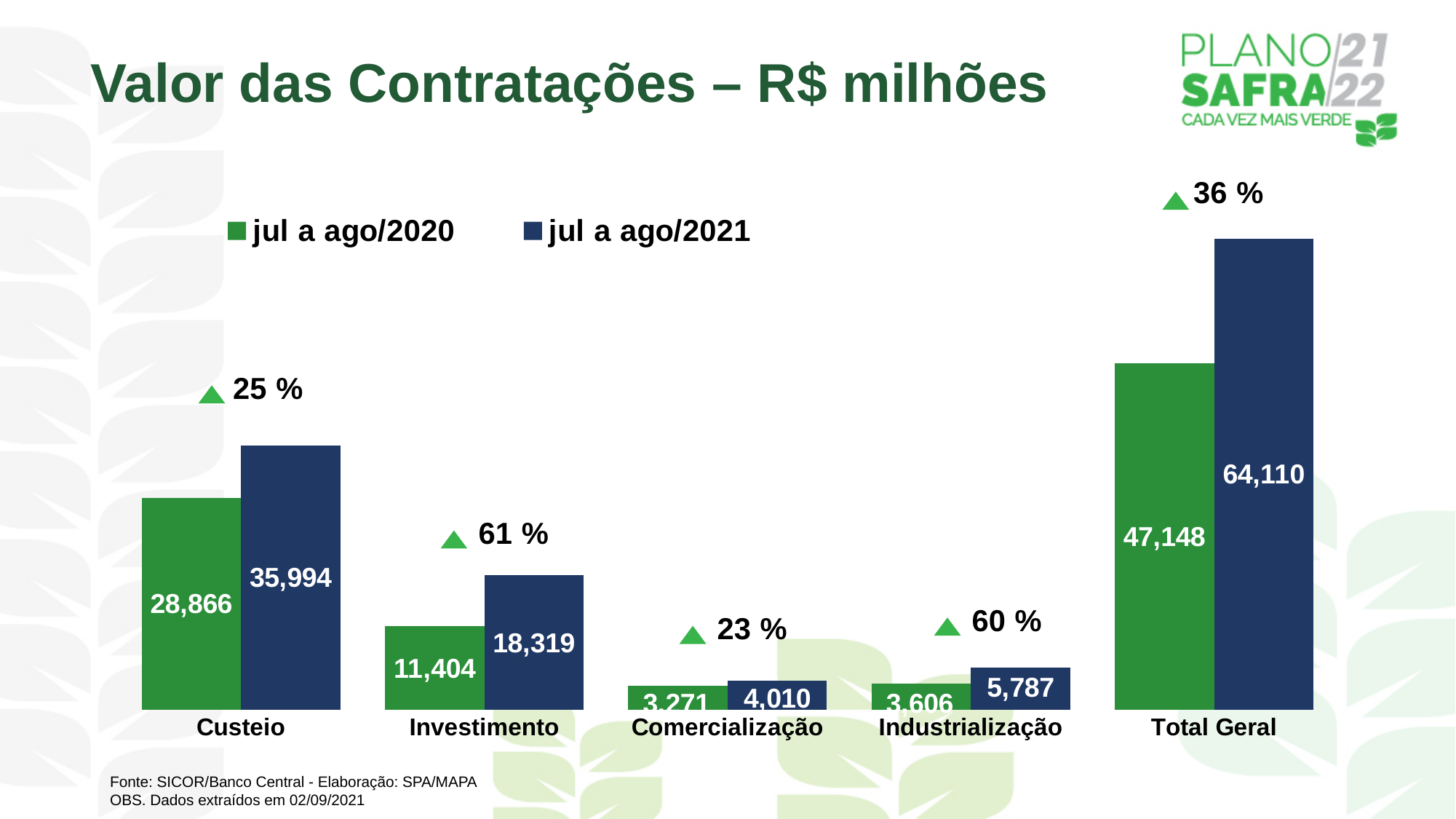
What is the difference between the jul a ago/2021 and jul a ago/2020 values for Custeio? 7,128 What is the value for Custeio in jul a ago/2021? 35,994 What percentage increase is shown above the Investimento bars? 61 % Excluding Total Geral, which category has the highest value in jul a ago/2020? Custeio What is the value for Total Geral in jul a ago/2021? 64,110 What is the value for Investimento in jul a ago/2020? 11,404 What is the value for Industrialização in jul a ago/2021? 5,787 How many categories are shown on the x axis? 5 How many series does the legend list? 2 Excluding Total Geral, which category has the lowest value in jul a ago/2021? Comercialização What kind of chart is shown on the slide? bar chart Which is larger for Investimento: the jul a ago/2020 value or the jul a ago/2021 value? jul a ago/2021